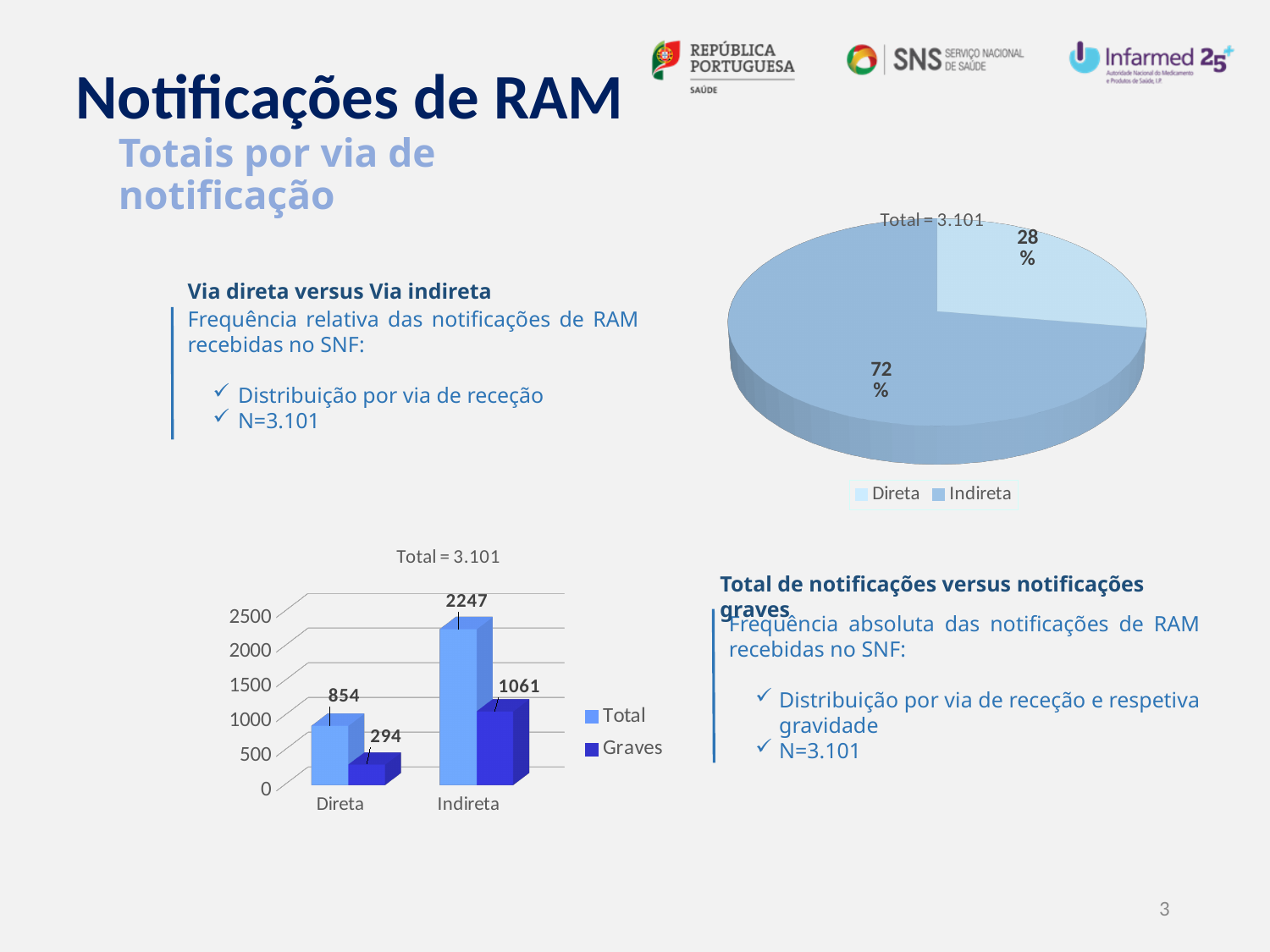
In the pie chart at the top right, what share of notifications is Indireta? 72% In the bar chart at the bottom left, what is the Graves value for Direta? 294 How many series does the legend of the bar chart at the bottom left list? 2 In the bar chart at the bottom left, what is the difference between the Total and Graves values for Indireta? 1186 In the pie chart at the top right, what share of notifications is Direta? 28% What kind of chart is the chart at the top right of the slide? Pie chart What kind of chart is the chart at the bottom left of the slide? Bar chart In the bar chart at the bottom left, what is the Total value for Indireta? 2247 In the bar chart at the bottom left, which series has the lowest value for Direta? Graves In the bar chart at the bottom left, which category has the highest Total value? Indireta In the pie chart at the top right, which slice is larger, Direta or Indireta? Indireta How many entries does the legend of the pie chart at the top right list? 2